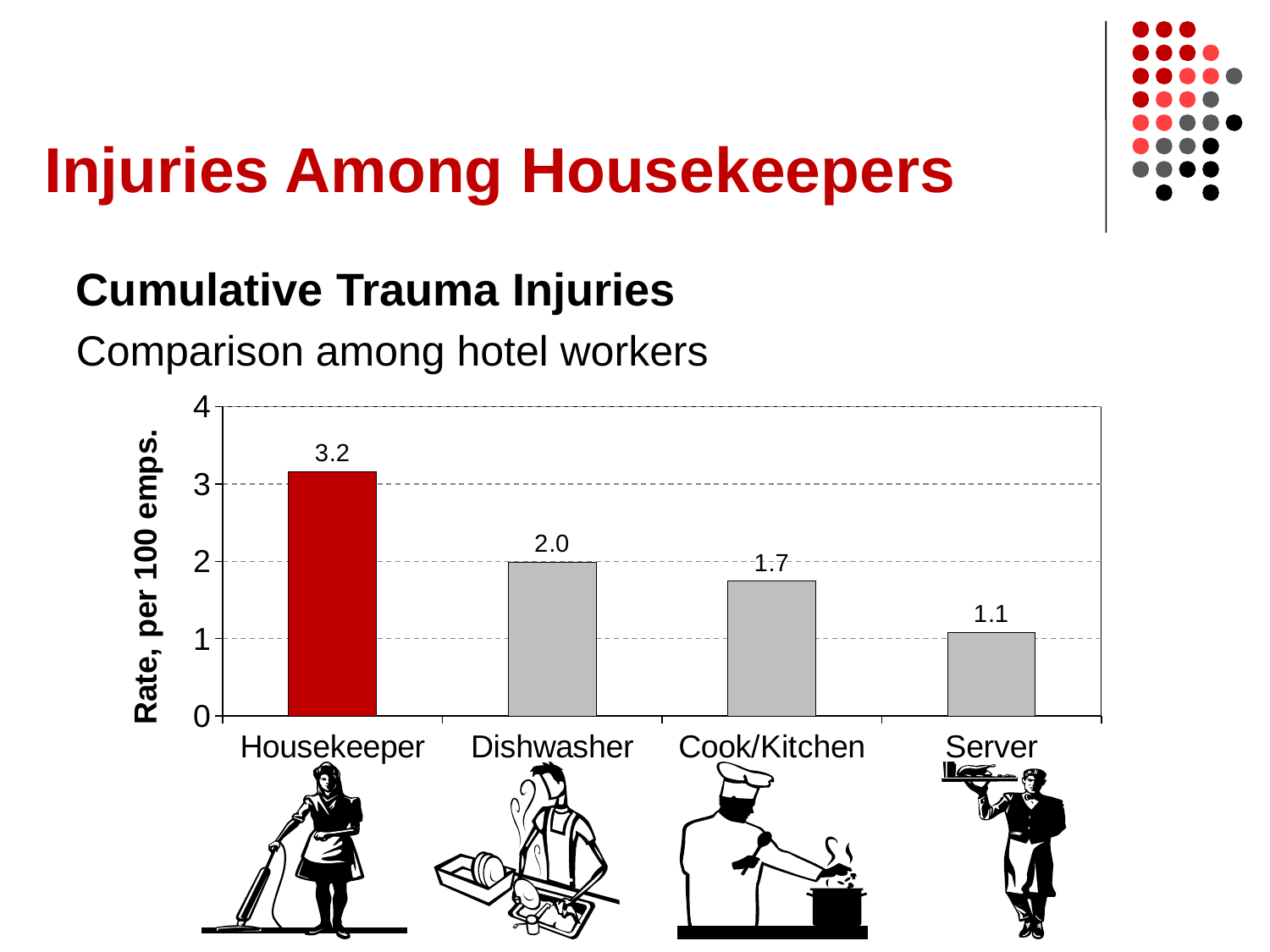
What is the cumulative trauma injury rate for Dishwasher? 2.0 Which hotel worker category has the lowest injury rate? Server What is the difference between the injury rates for Cook/Kitchen and Server? 0.6 What is the difference between the injury rates for Housekeeper and Dishwasher? 1.2 Which has a higher injury rate, Dishwasher or Cook/Kitchen? Dishwasher What kind of chart is shown on the slide? Bar chart What is the cumulative trauma injury rate for Cook/Kitchen? 1.7 What is the label of the vertical axis of the chart? Rate, per 100 emps. How many worker categories are shown in the chart? 4 Which hotel worker category has the highest injury rate? Housekeeper What is the cumulative trauma injury rate for Server? 1.1 What is the cumulative trauma injury rate for Housekeeper? 3.2